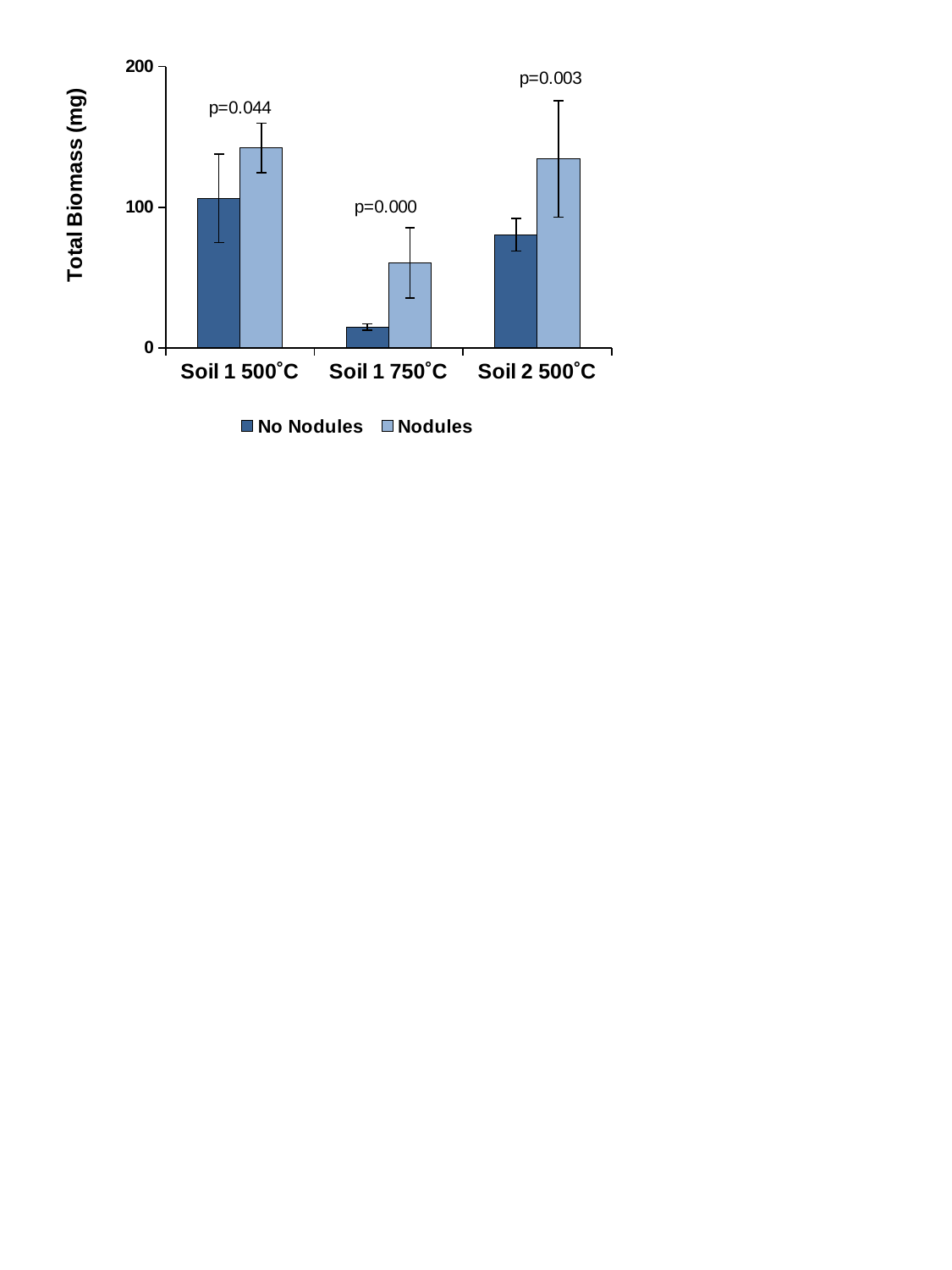
Which category has the lowest Nodules value? Soil 1 750˚C Is the Nodules value for Soil 2 500˚C greater or less than 100? greater Is the No Nodules value for Soil 2 500˚C greater or less than 100? less For Soil 1 750˚C, which is larger: the No Nodules value or the Nodules value? Nodules Which category has the lowest No Nodules value? Soil 1 750˚C What is the label of the y axis? Total Biomass (mg) How many categories are shown on the x axis? 3 What kind of chart is shown on the slide? bar chart Is the No Nodules value for Soil 1 750˚C greater or less than 100? less For Soil 2 500˚C, which is larger: the No Nodules value or the Nodules value? Nodules How many series does the legend list? 2